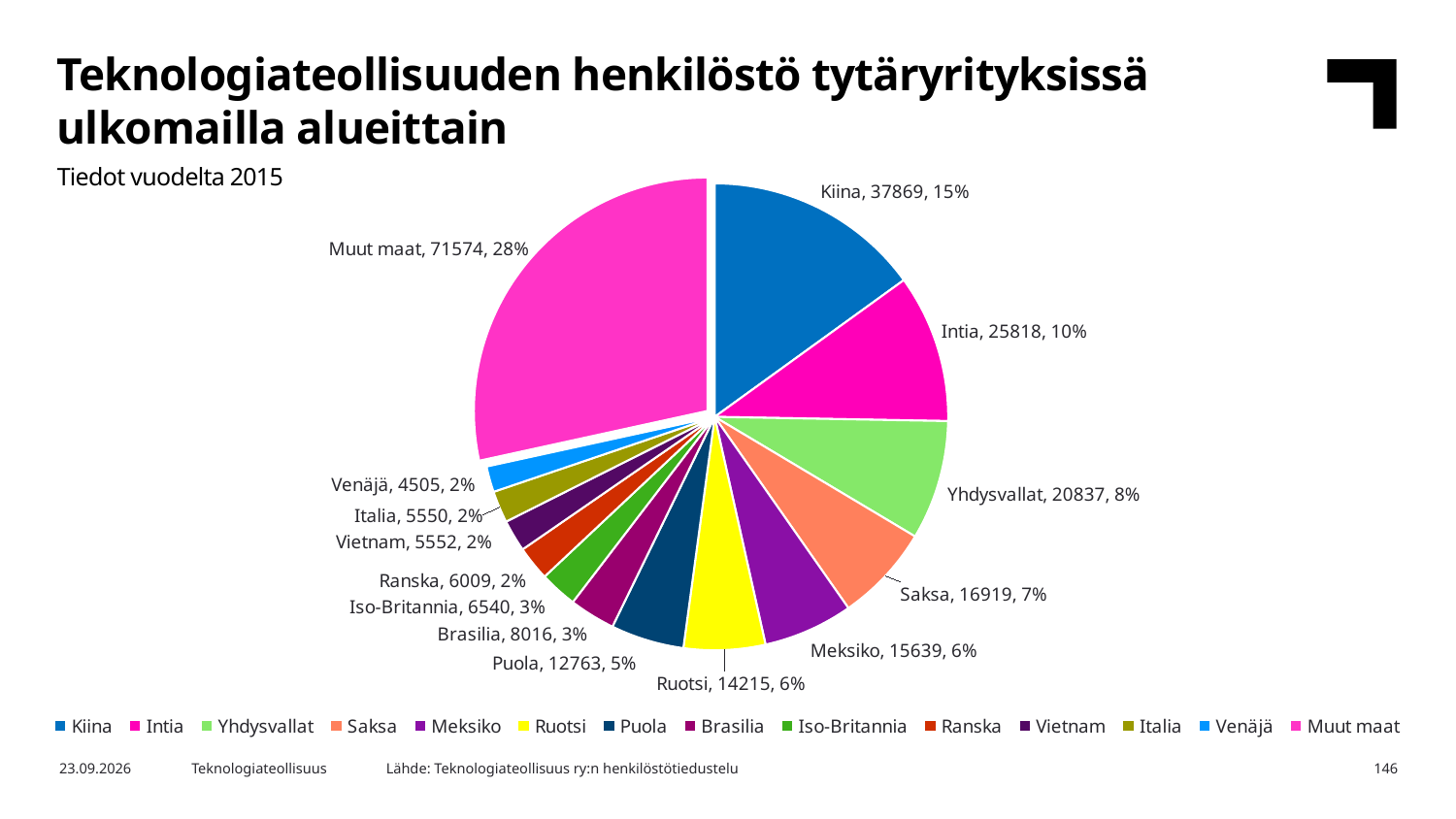
What kind of chart is shown on the slide? pie chart What is the value for Puola? 12763 Which slice is the largest? Muut maat What year does the data on the slide come from? 2015 What is the value for Kiina? 37869 Which slice is the smallest? Venäjä How many slices does the pie chart have? 14 Which is larger, the value for Meksiko or the value for Ruotsi? Meksiko What is the difference between the values for Kiina and Intia? 12051 What is the value for Saksa? 16919 What share of the pie does Intia represent? 10% What share of the pie does Muut maat represent? 28%